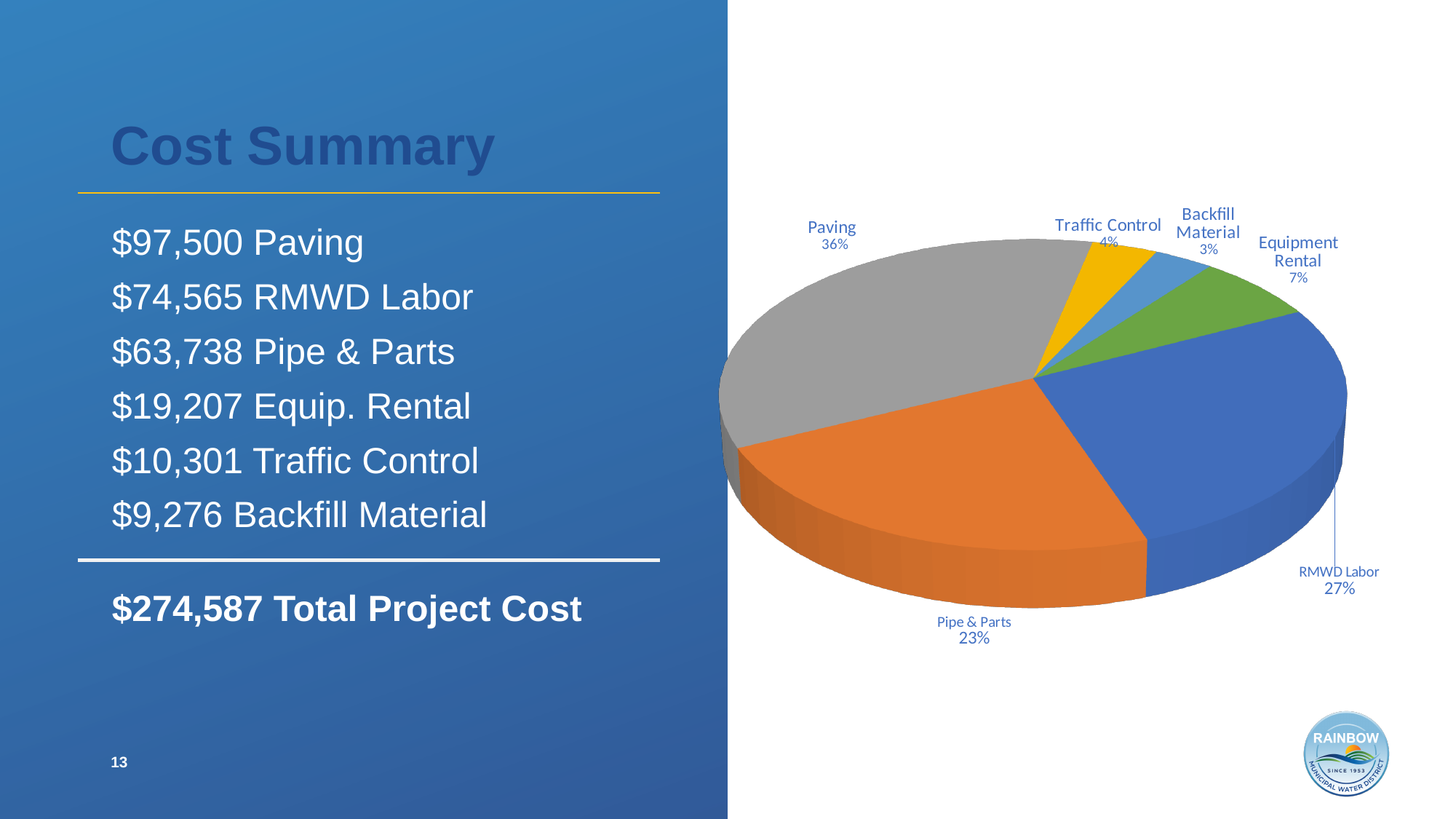
What kind of chart is shown on the slide? pie chart How many slices does the pie chart have? 6 What is the difference in percentage points between the Equipment Rental share and the Traffic Control share? 3 What share of the pie does Paving represent? 36% What share of the pie does Backfill Material represent? 3% What share of the pie does Pipe & Parts represent? 23% Which category has the smallest slice of the pie? Backfill Material What is the difference in percentage points between the Paving share and the RMWD Labor share? 9 What share of the pie does Equipment Rental represent? 7% Which category has the largest slice of the pie? Paving Which is larger, the share for RMWD Labor or the share for Pipe & Parts? RMWD Labor What share of the pie does RMWD Labor represent? 27%